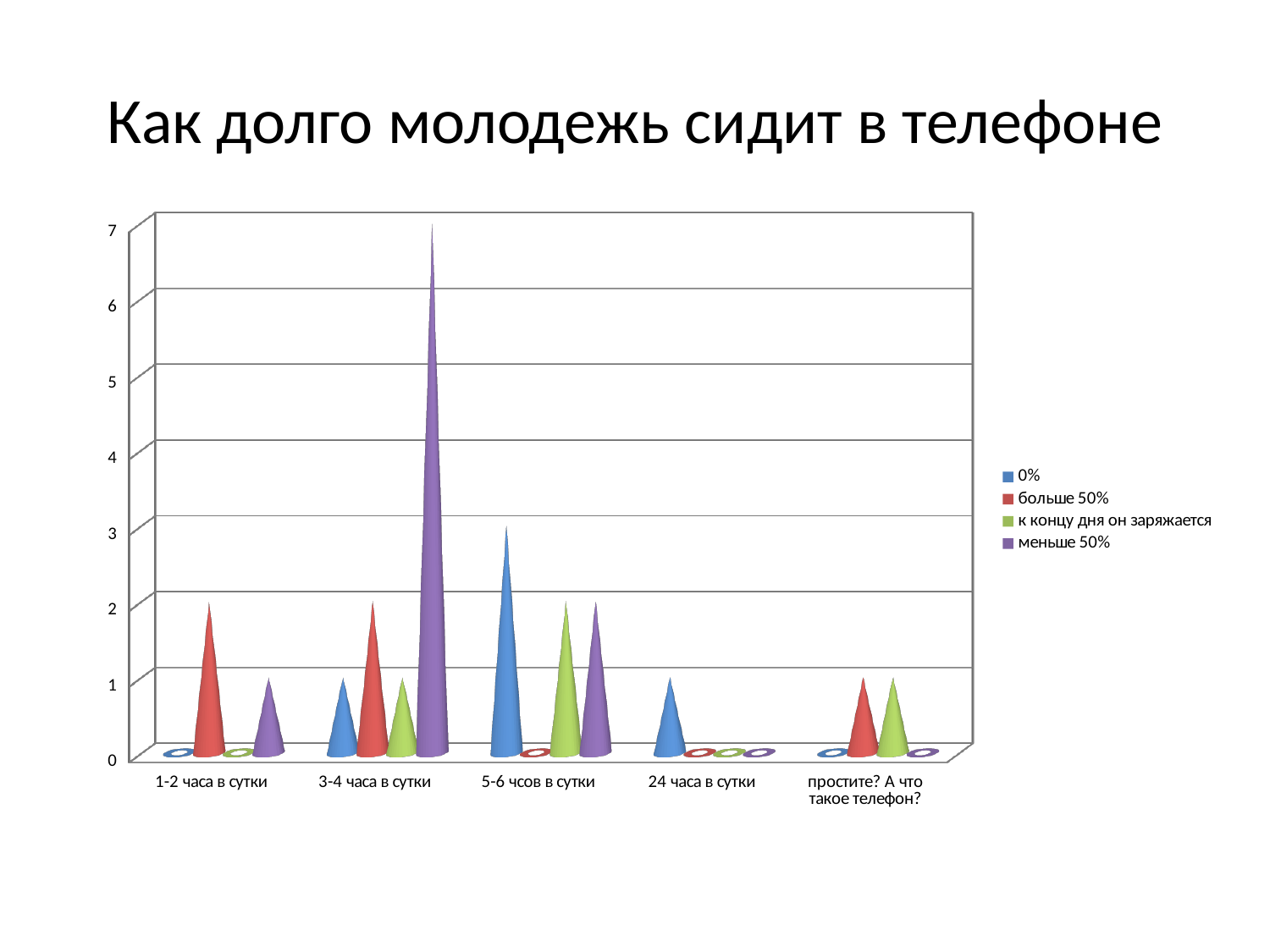
Is the value of the series 0% for 24 часа в сутки greater or less than 2? less Is the value of the series меньше 50% for 3-4 часа в сутки greater or less than 6? greater What is the title of the chart? Как долго молодежь сидит в телефоне Which category has the tallest bar in the chart? 3-4 часа в сутки Which series has the highest value for the category 3-4 часа в сутки? меньше 50% What kind of chart is shown on the slide? bar chart What is the value of the series 0% for the category 5-6 чсов в сутки? 3 How many series does the legend list? 4 Which series is shown in purple in the legend? меньше 50% What is the value of the series меньше 50% for the category 3-4 часа в сутки? 7 For the category 5-6 чсов в сутки, which is larger: the value for 0% or the value for больше 50%? 0% How many categories are shown on the x axis? 5